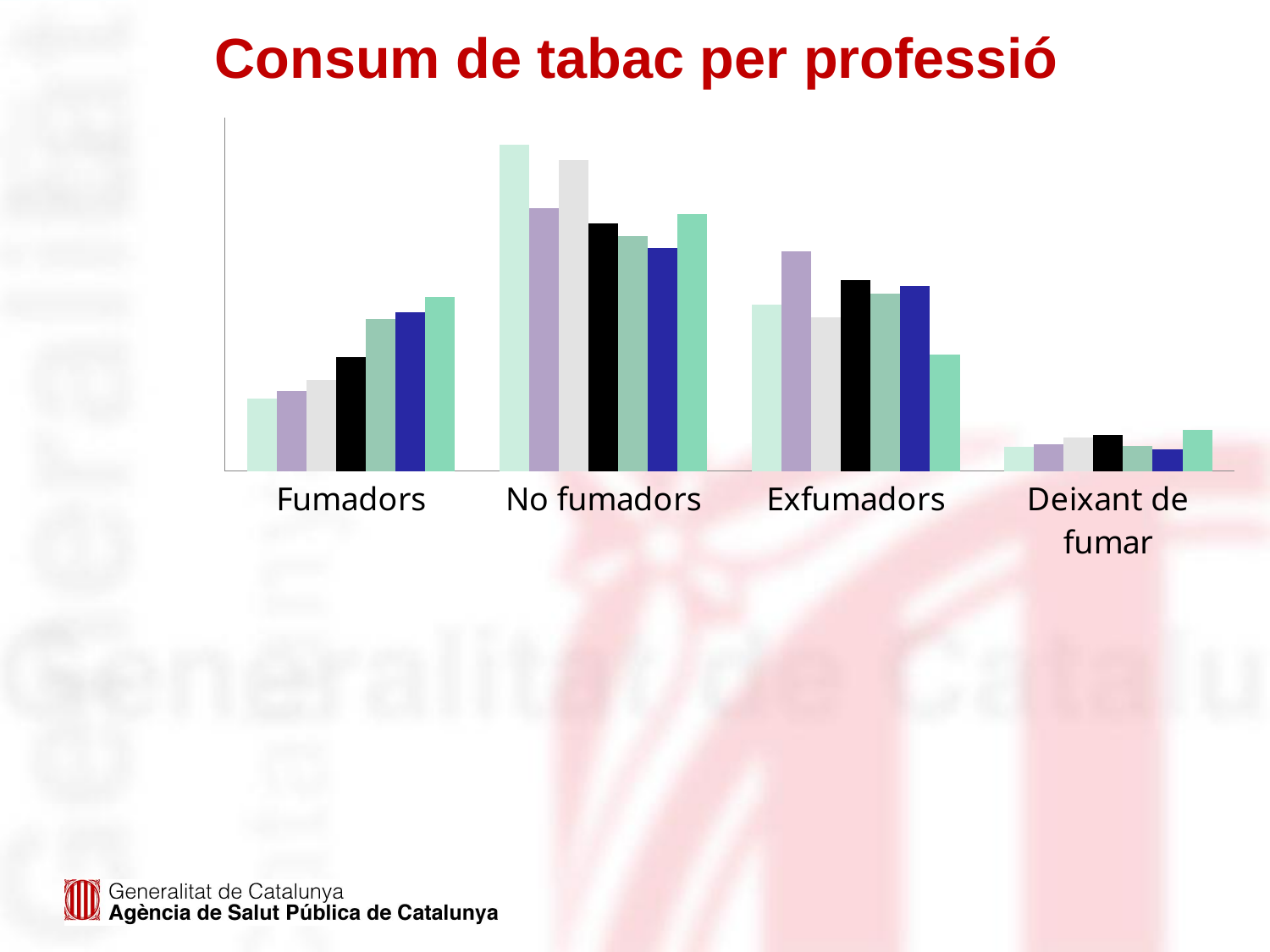
Do the bars rise or fall from the Exfumadors category to the Deixant de fumar category? Fall Do the bars rise or fall from the Fumadors category to the No fumadors category? Rise Is the tallest bar in the Fumadors group higher or lower than the tallest bar in the Exfumadors group? Lower What kind of chart is shown on the slide? Bar chart Which category has the shortest bars in the chart? Deixant de fumar How many categories are shown on the x axis of the chart? 4 Does the chart display a legend identifying the bar series? No How many bars are plotted for each category in the chart? 7 What is the title of the chart? Consum de tabac per professió Which category contains the tallest bar in the chart? No fumadors